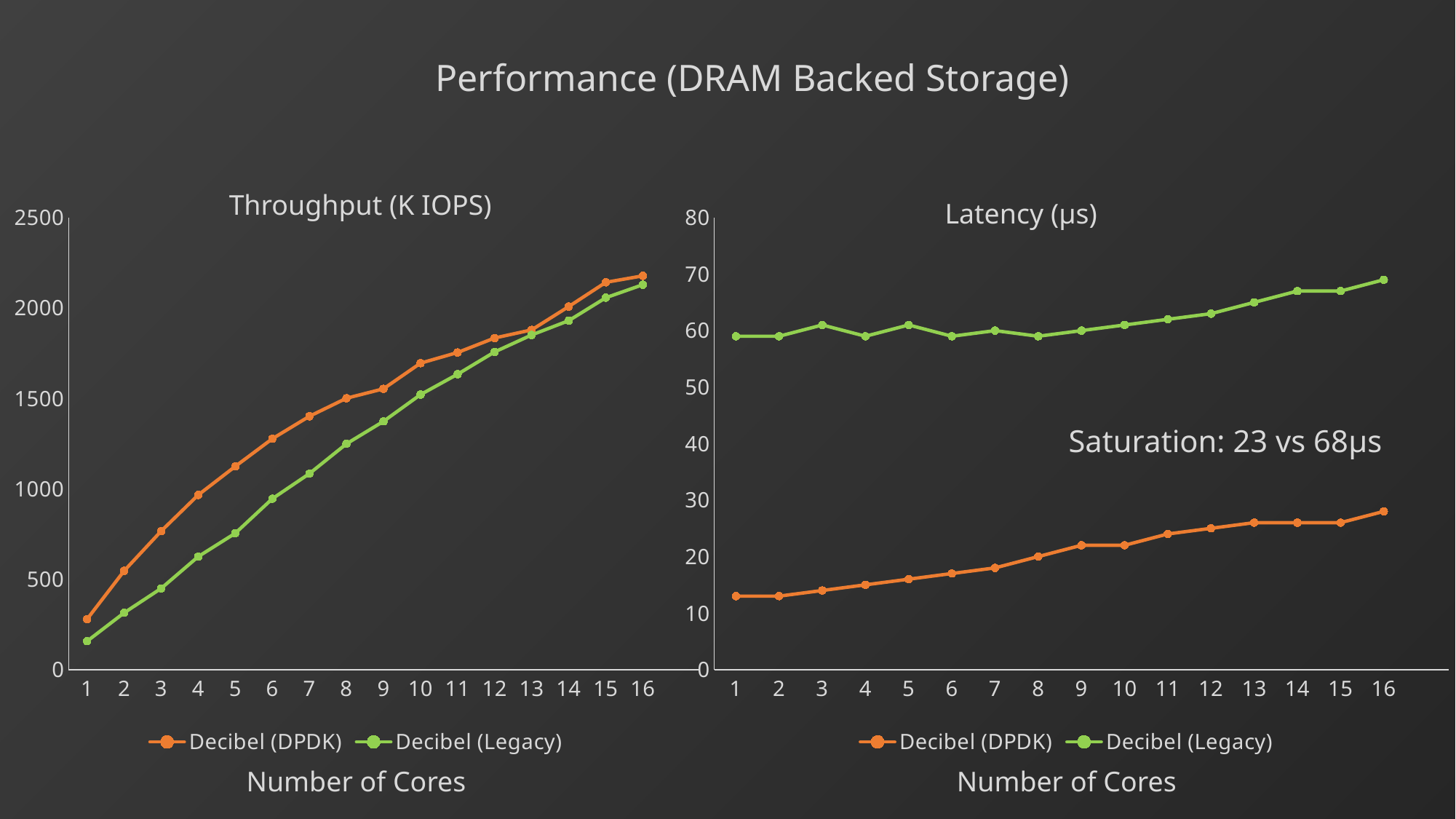
What saturation latencies does the annotation on the Latency (µs) chart state? 23 vs 68µs In the Latency (µs) chart, which series has the higher value at 16 cores, Decibel (DPDK) or Decibel (Legacy)? Decibel (Legacy) In the Throughput (K IOPS) chart, is the Decibel (Legacy) value at 16 cores greater or less than 2000? greater In the Throughput (K IOPS) chart, do the Decibel (DPDK) values rise or fall as the number of cores increases? rise In the Throughput (K IOPS) chart, is the Decibel (Legacy) value at 4 cores greater or less than 500? greater How many points are plotted along the x axis for each series in the Throughput (K IOPS) chart? 16 In the Latency (µs) chart, is the Decibel (Legacy) value at 16 cores greater or less than 60? greater How many series does the legend of the Latency (µs) chart list? 2 In the Throughput (K IOPS) chart, which series has the higher value at 4 cores, Decibel (DPDK) or Decibel (Legacy)? Decibel (DPDK) What kind of chart is the Throughput (K IOPS) chart? line chart